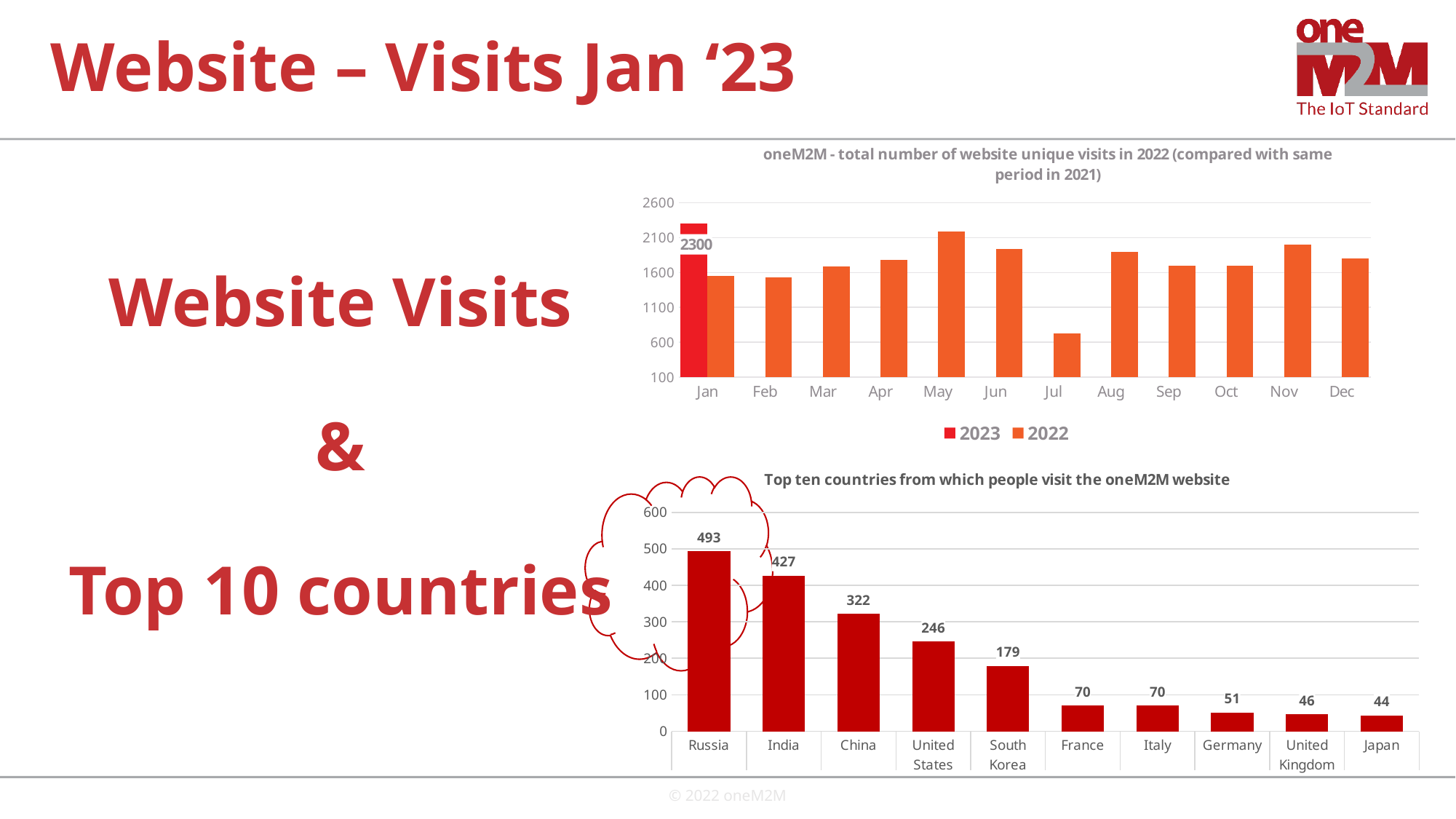
In the top chart (website unique visits), is the 2022 value for Jul greater or less than 1100? less In the bottom chart (top ten countries), what is the difference between Russia and India? 66 In the top chart (website unique visits), which month has the highest 2022 value? May In the top chart (website unique visits), what is the value for Jan 2023? 2300 In the bottom chart (top ten countries), what is the value for Russia? 493 In the bottom chart (top ten countries), which country has the lowest value? Japan In the bottom chart (top ten countries), which is larger, China or United States? China In the bottom chart (top ten countries), what kind of chart is it? bar chart In the top chart (website unique visits), which month has the lowest 2022 value? Jul In the bottom chart (top ten countries), do the values rise or fall from left to right? fall In the top chart (website unique visits), how many months are shown on the x axis? 12 In the top chart (website unique visits), how many series does the legend list? 2